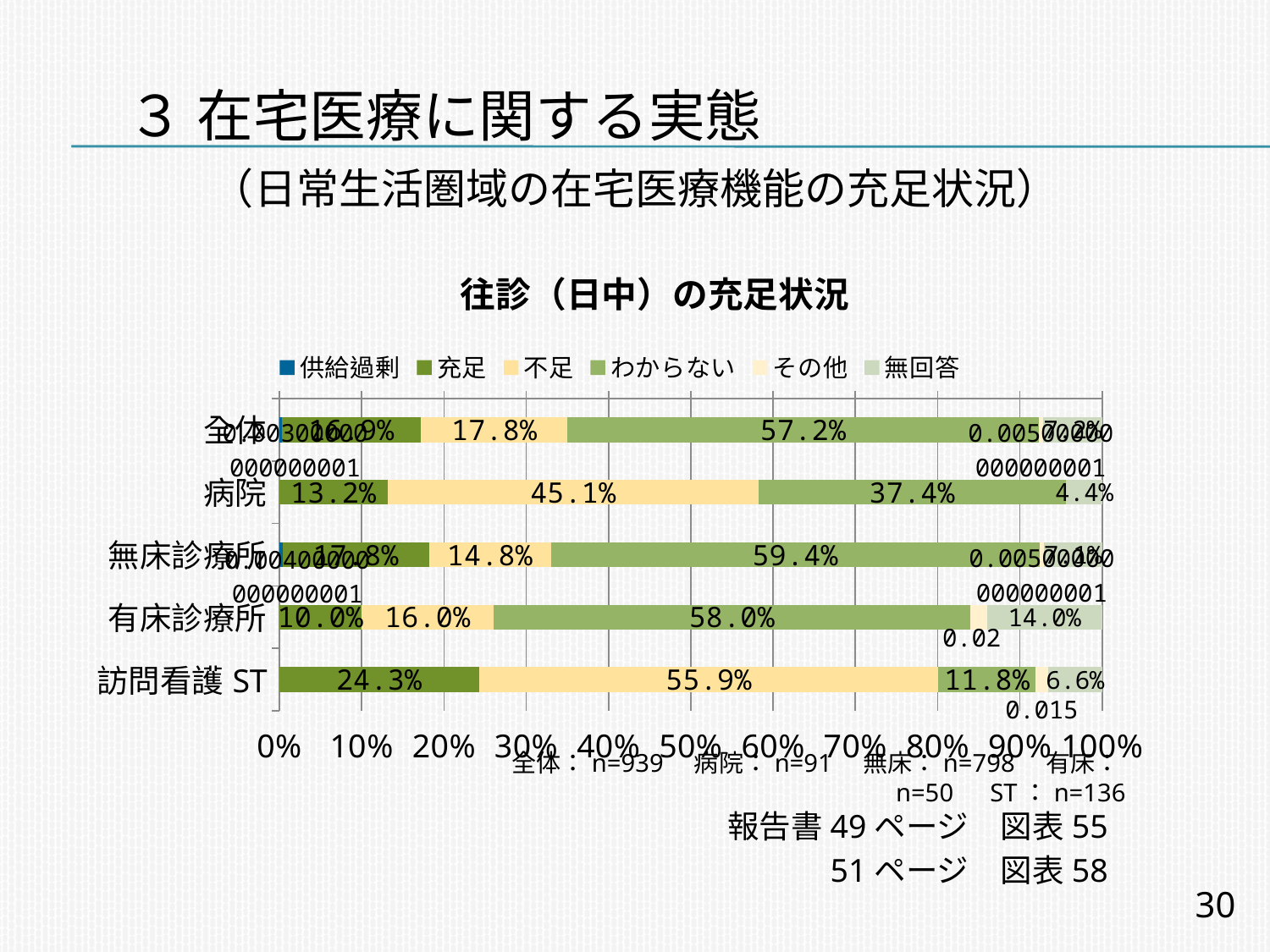
What is the 無回答 value for 病院? 4.4% What is the 充足 value for 有床診療所? 10.0% What is the わからない value for 訪問看護ST? 11.8% How many categories are plotted on the y axis? 5 What is the difference between the 不足 values for 病院 and 有床診療所? 29.1% Which category has the highest 不足 value? 訪問看護ST What is the 不足 value for 病院? 45.1% Which category has the lowest 充足 value? 有床診療所 What kind of chart is shown on the slide? stacked bar chart How many series does the legend list? 6 Which is larger, the わからない value for 病院 or for 有床診療所? 有床診療所 What is the 不足 value for 訪問看護ST? 55.9%